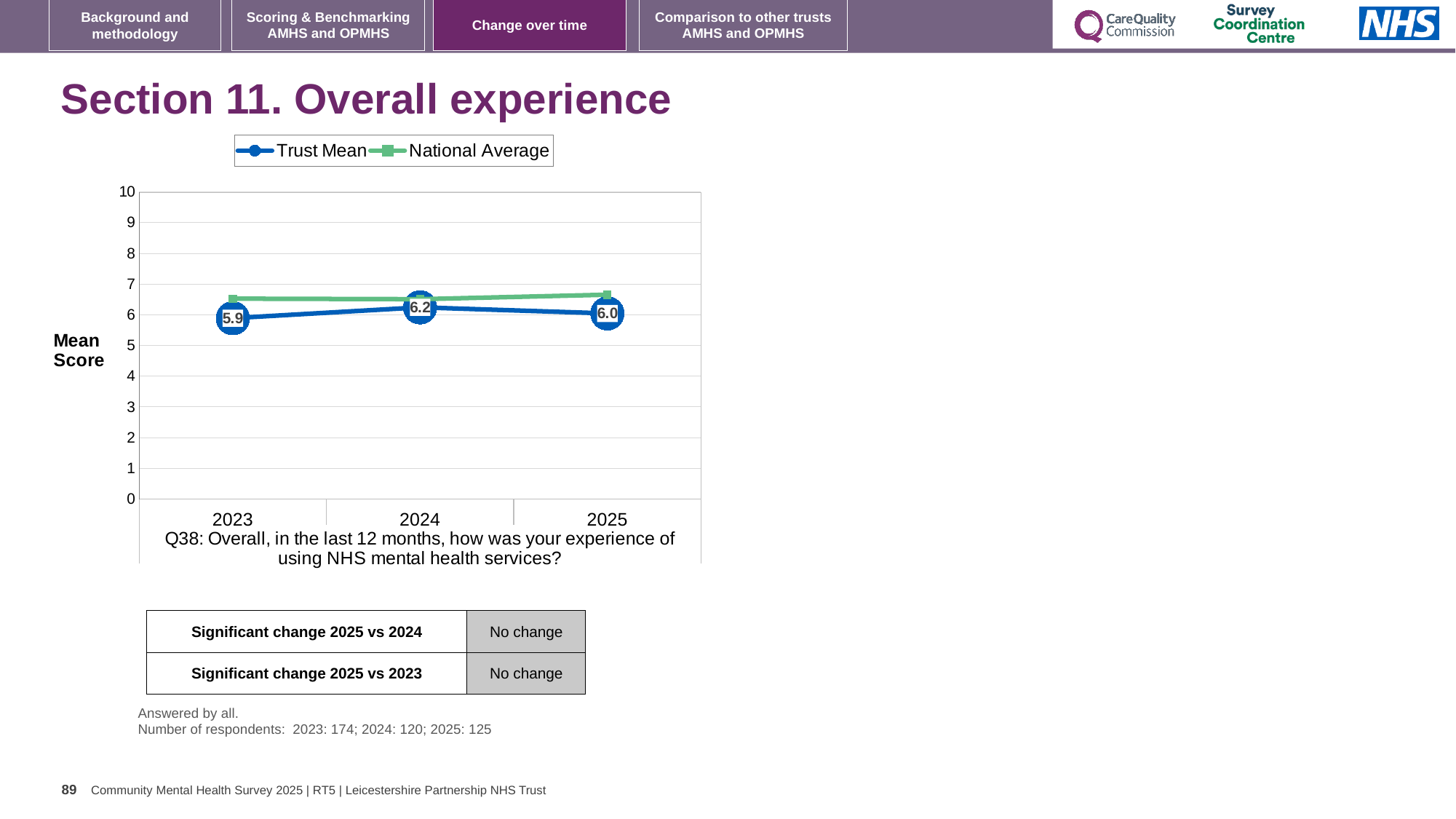
What is the Trust Mean score for 2025? 6.0 In which year is the Trust Mean lowest? 2023 What kind of chart is shown on the slide? Line chart Which is larger, the Trust Mean in 2024 or in 2025? 2024 In which year is the Trust Mean highest? 2024 What is the difference between the Trust Mean in 2024 and in 2023? 0.3 What is the Trust Mean score for 2024? 6.2 Is the National Average value for 2025 greater or less than 6? greater How many years are plotted on the x axis? 3 What is the Trust Mean score for 2023? 5.9 What is the label of the y axis? Mean Score How many series does the legend list? 2